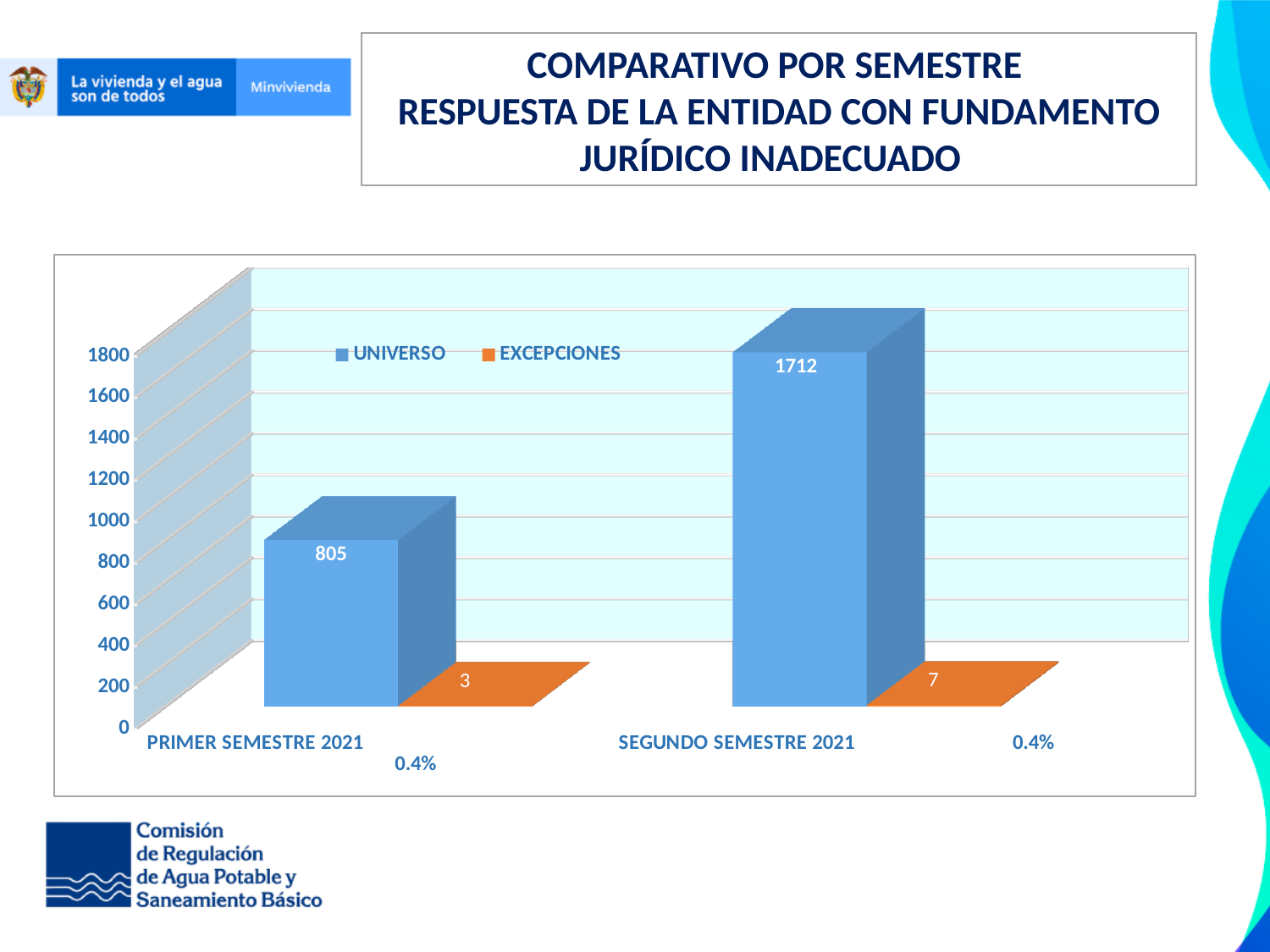
Which semester has the lower EXCEPCIONES value? PRIMER SEMESTRE 2021 What is the UNIVERSO value for SEGUNDO SEMESTRE 2021? 1712 What is the UNIVERSO value for PRIMER SEMESTRE 2021? 805 What percentage is shown below each semester on the chart? 0.4% How many series does the legend list? 2 Is the UNIVERSO value for PRIMER SEMESTRE 2021 greater or less than 1000? less What is the difference between the EXCEPCIONES values for SEGUNDO SEMESTRE 2021 and PRIMER SEMESTRE 2021? 4 What is the difference between the UNIVERSO values for SEGUNDO SEMESTRE 2021 and PRIMER SEMESTRE 2021? 907 What is the EXCEPCIONES value for SEGUNDO SEMESTRE 2021? 7 What is the EXCEPCIONES value for PRIMER SEMESTRE 2021? 3 What kind of chart is shown on the slide? bar chart Which semester has the higher UNIVERSO value? SEGUNDO SEMESTRE 2021